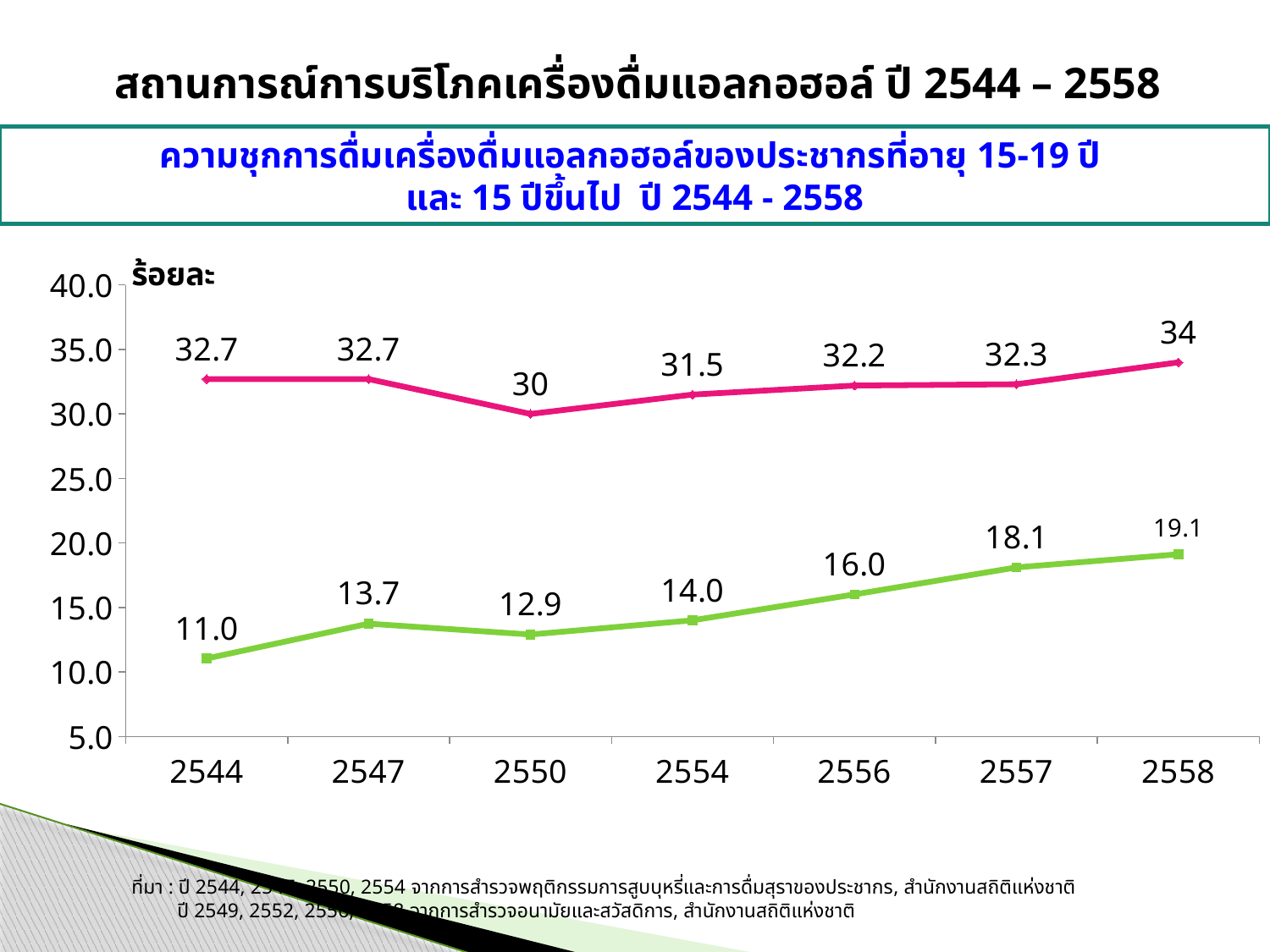
In which year does the green line reach its highest value? 2558 What is the value of the pink line in 2558? 34 What is the difference between the pink line and the green line in 2558? 14.9 Is the value of the green line in 2556 greater or less than 15.0? greater Which is larger, the green line's value in 2547 or in 2550? 2547 Does the green line generally rise or fall from 2550 to 2558? rise What type of chart is shown on the slide? line chart What is the value of the green line in 2557? 18.1 How many years are shown on the x axis? 7 In which year does the pink line have its lowest value? 2550 What is the value of the green line in 2544? 11.0 What is the value of the pink line in 2550? 30